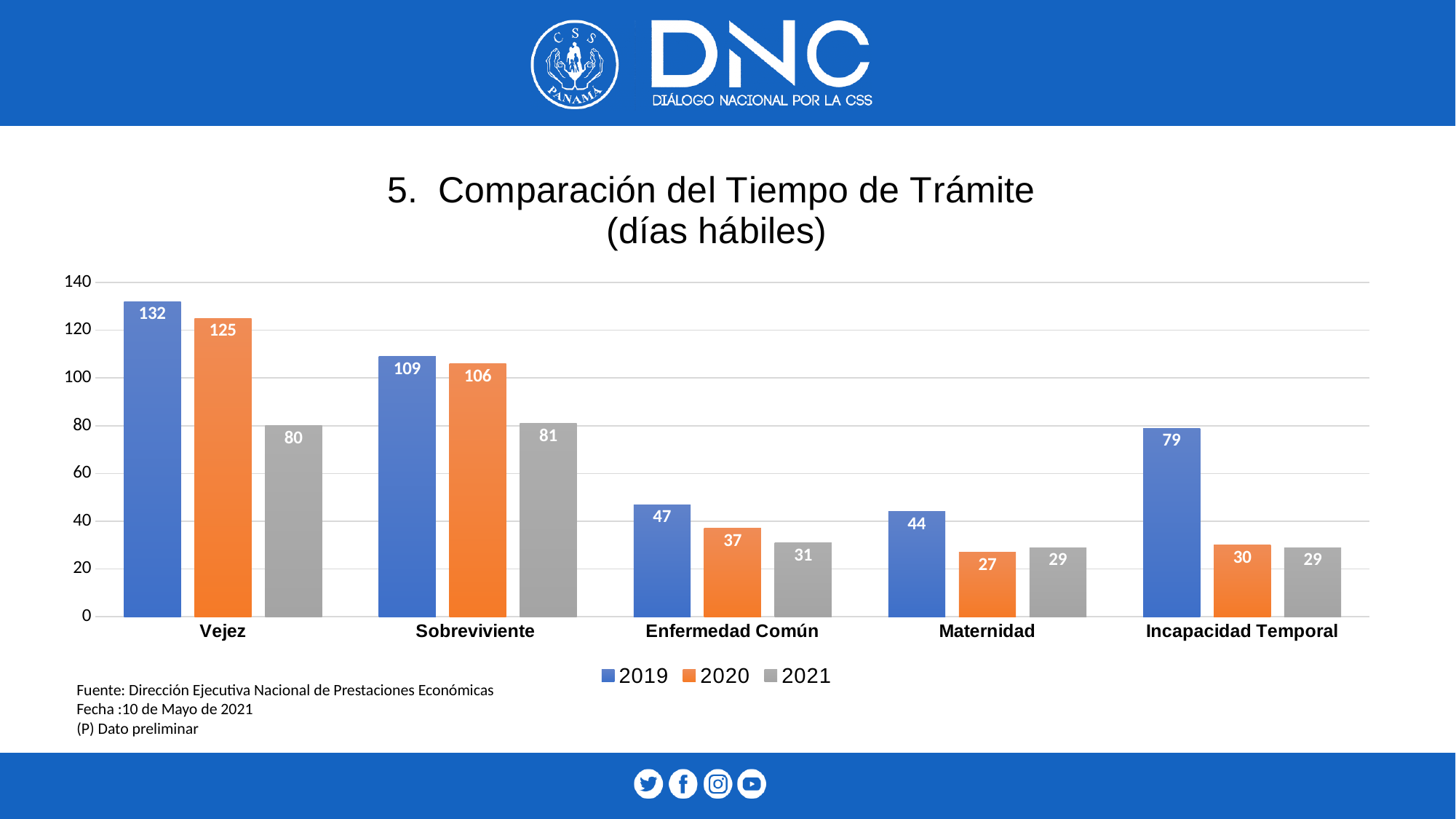
What is the title of the chart? 5. Comparación del Tiempo de Trámite (días hábiles) How many categories are shown on the x axis? 5 What is the value for Incapacidad Temporal in 2021? 29 Does the value for Vejez rise or fall from 2019 to 2021? Fall How many series does the legend list? 3 Which category has the highest value in 2019? Vejez Which is larger, the 2020 value for Enfermedad Común or the 2020 value for Incapacidad Temporal? Enfermedad Común What kind of chart is shown on the slide? Bar chart What is the difference between the 2019 and 2021 values for Sobreviviente? 28 What is the value for Vejez in 2019? 132 What is the value for Maternidad in 2020? 27 Which category has the lowest value in 2020? Maternidad